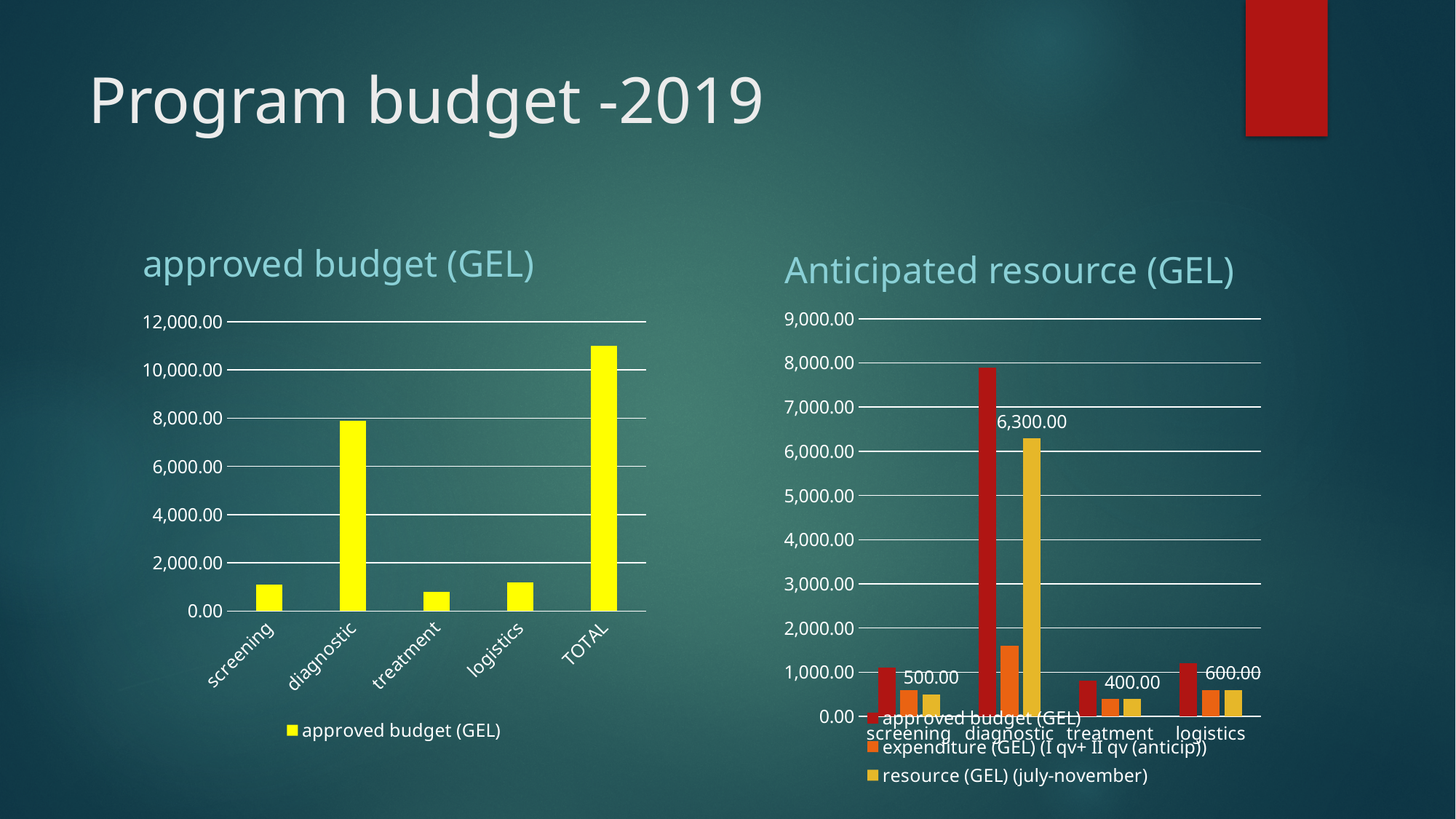
In the 'Anticipated resource (GEL)' chart, what is the labelled value of the 'resource (GEL) (july-november)' series for treatment? 400.00 In the 'Anticipated resource (GEL)' chart, which category has the lowest 'resource (GEL) (july-november)' value? treatment In the 'Anticipated resource (GEL)' chart, is the 'approved budget (GEL)' value for diagnostic greater or less than 7,000.00? greater In the 'approved budget (GEL)' chart, how many categories are shown on the x axis? 5 What kind of chart is the 'approved budget (GEL)' chart on the left? bar chart In the 'Anticipated resource (GEL)' chart, what is the labelled value of the 'resource (GEL) (july-november)' series for diagnostic? 6,300.00 In the 'approved budget (GEL)' chart, which category has the lowest bar? treatment In the 'approved budget (GEL)' chart, is the value for diagnostic greater or less than 6,000.00? greater In the 'approved budget (GEL)' chart, which category has the highest bar? TOTAL In the 'approved budget (GEL)' chart, is the value for screening greater or less than 2,000.00? less In the 'Anticipated resource (GEL)' chart, what is the difference between the 'resource (GEL) (july-november)' values for diagnostic and screening? 5,800.00 In the 'Anticipated resource (GEL)' chart, how many series does the legend list? 3